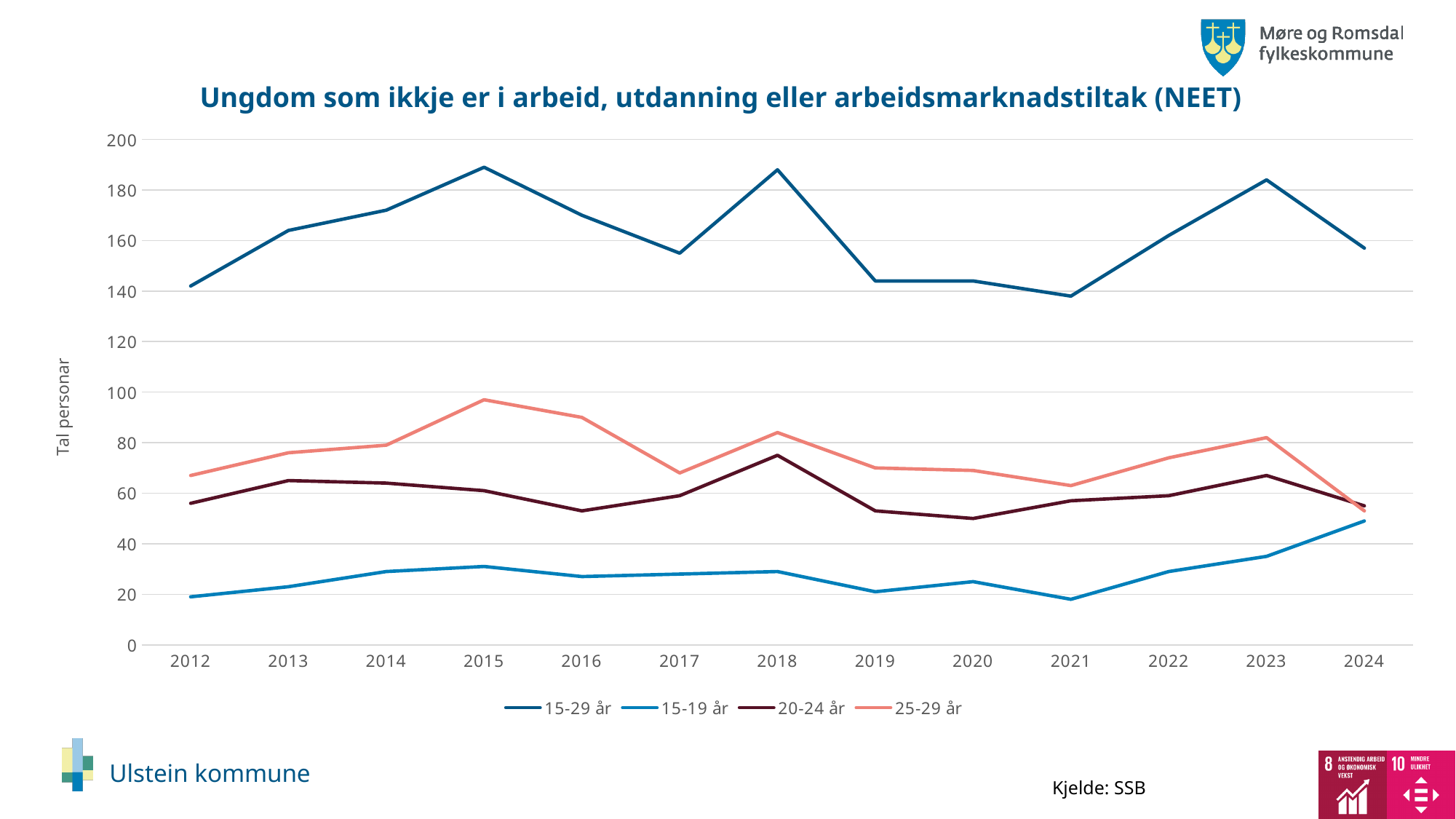
In which year does the 25-29 år series reach its highest value? 2015 How many series does the legend list? 4 In 2015, which series has the larger value: 25-29 år or 20-24 år? 25-29 år In which year does the 25-29 år series reach its lowest value? 2024 Does the 15-19 år series rise or fall from 2021 to 2024? rise In which year does the 20-24 år series reach its highest value? 2018 What kind of chart is shown on the slide? line chart How many years are shown on the x axis? 13 In which year does the 15-19 år series reach its highest value? 2024 Is the value for 25-29 år in 2015 greater or less than 90? greater Is the value for 15-29 år in 2015 greater or less than 180? greater